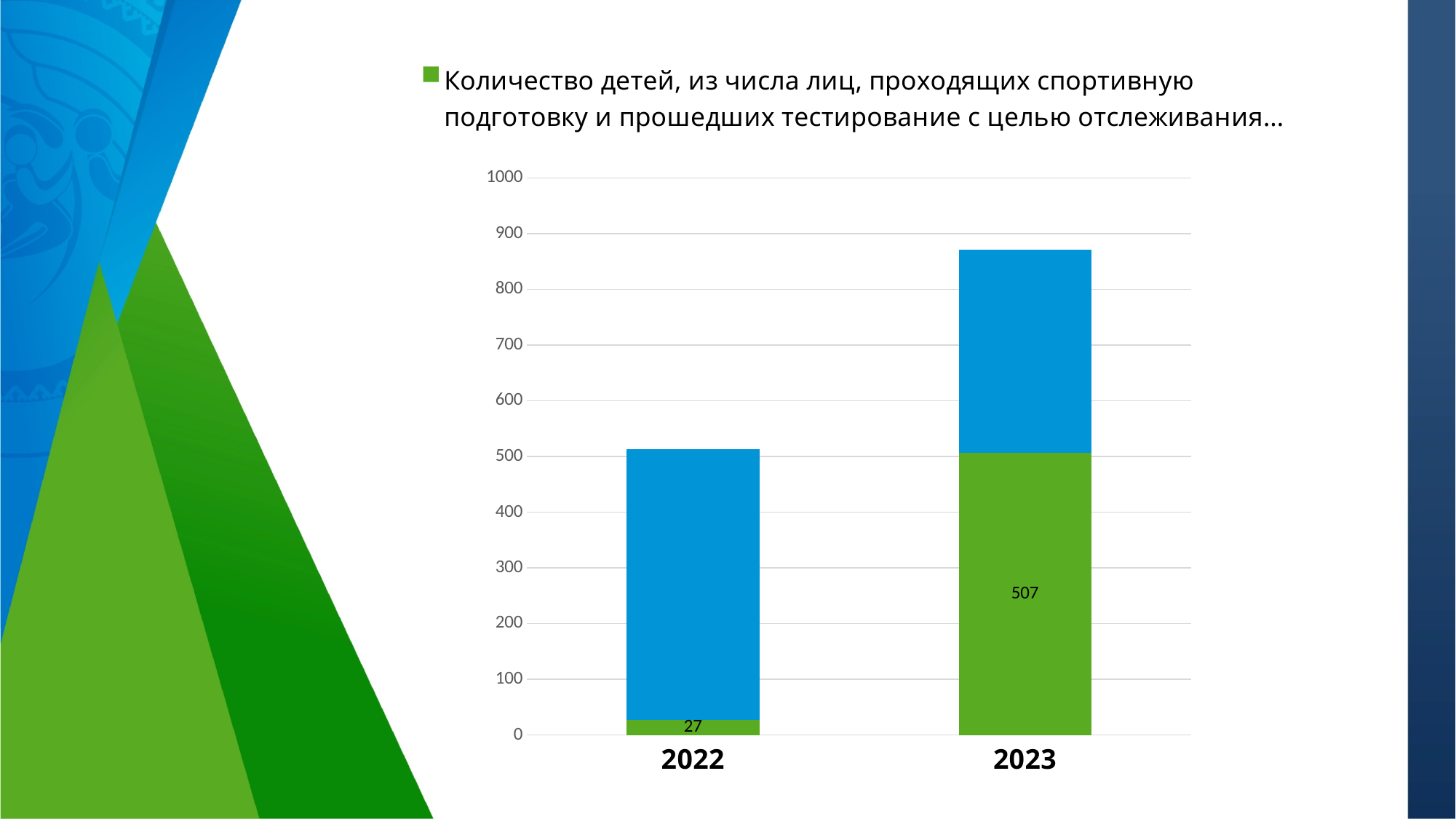
Which year has the lowest green series value? 2022 Is the total height of the stacked bar for 2022 greater or less than 600? less Does the green series value rise or fall from 2022 to 2023? Rise Which year has the larger green series value, 2022 or 2023? 2023 What is the value of the green series for 2023? 507 How many series does the legend list? 1 How many categories are shown on the x axis? 2 What kind of chart is shown on the slide? Bar chart Which year has the highest green series value? 2023 What is the value of the green series for 2022? 27 What is the difference between the green series values for 2023 and 2022? 480 Is the total height of the stacked bar for 2023 greater or less than 800? greater